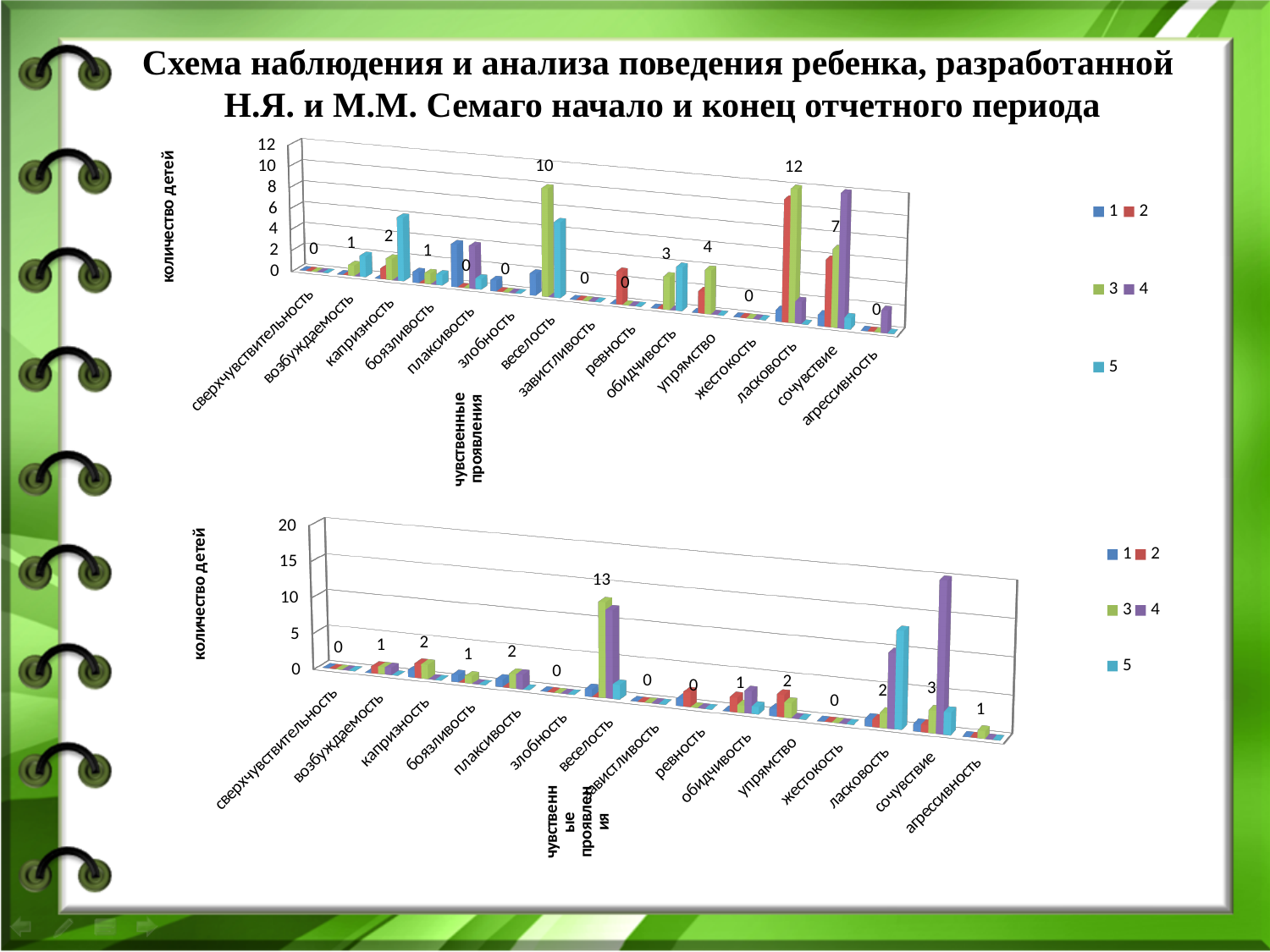
How many series does the legend of the top chart list? 5 What type of chart is shown at the top of the slide? bar chart How many categories are shown along the x axis of the bottom chart? 15 Among the data labels printed on the top chart, which category has the highest value? ласковость In the top chart, what is the difference between the printed labels for ласковость and сочувствие? 5 In the top chart, what data label is printed for сочувствие? 7 In the bottom chart, what data label is printed for веселость? 13 In the top chart, what data label is printed for веселость? 10 In the top chart, which has the larger printed label: упрямство or обидчивость? упрямство Among the data labels printed on the bottom chart, which category has the highest value? веселость What is the title of the vertical axis on the bottom chart? количество детей In the top chart, what data label is printed for ласковость? 12